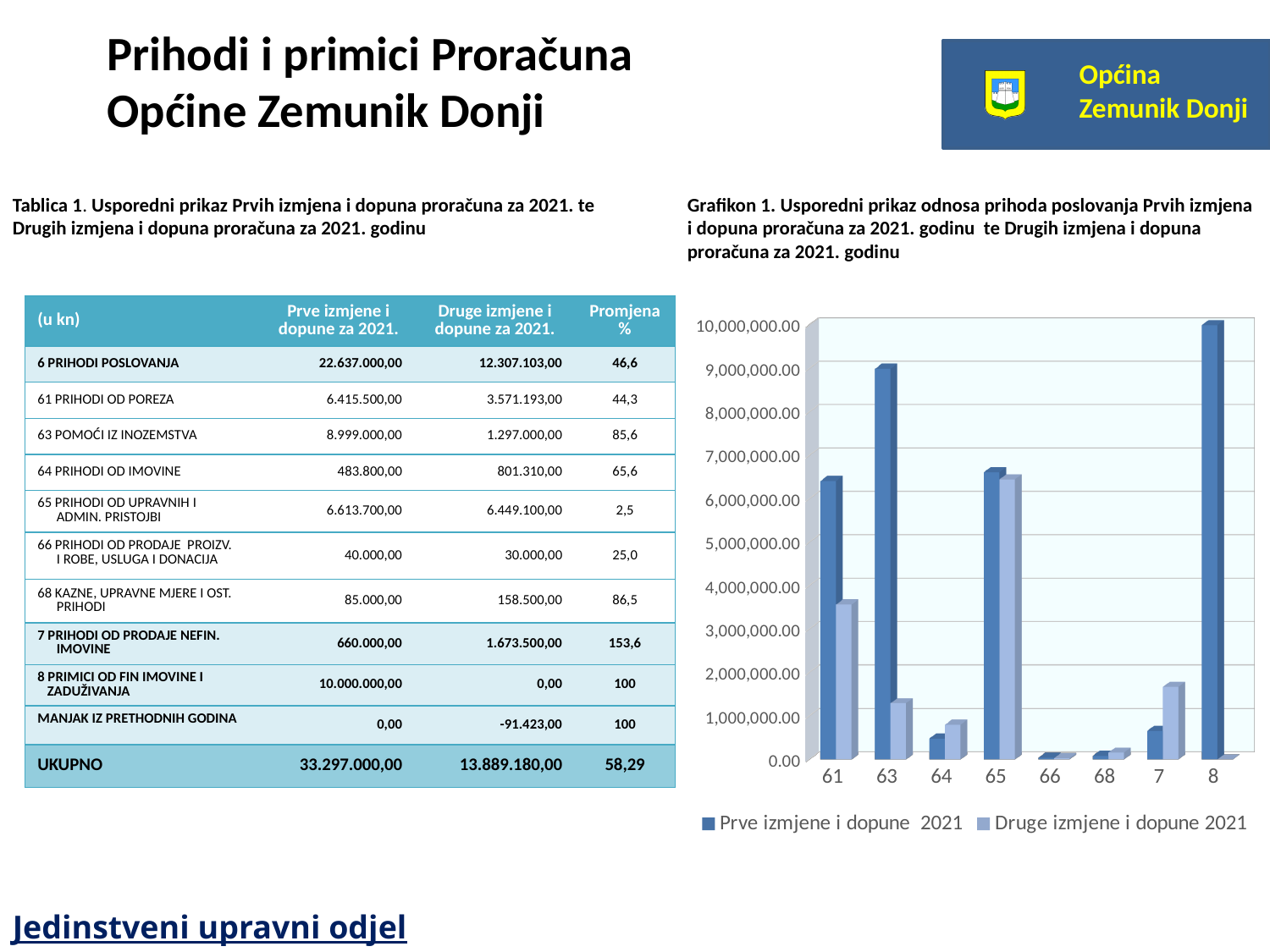
For category 63, which series has the larger value, Prve izmjene i dopune 2021 or Druge izmjene i dopune 2021? Prve izmjene i dopune 2021 What kind of chart is Grafikon 1 on the slide? bar chart For category 7, which series has the larger value, Prve izmjene i dopune 2021 or Druge izmjene i dopune 2021? Druge izmjene i dopune 2021 Is the value for category 61 in the Prve izmjene i dopune 2021 series greater or less than 6,000,000.00? greater Which category has the highest value in the Prve izmjene i dopune 2021 series? 8 Which category has the highest value in the Druge izmjene i dopune 2021 series? 65 Is the value for category 61 in the Druge izmjene i dopune 2021 series greater or less than 4,000,000.00? less How many series does the chart's legend list? 2 What are the two series named in the chart's legend? Prve izmjene i dopune 2021; Druge izmjene i dopune 2021 Which category has the lowest value in the Druge izmjene i dopune 2021 series? 8 How many categories are shown on the x axis of the chart? 8 Is the value for category 64 in the Prve izmjene i dopune 2021 series greater or less than 1,000,000.00? less